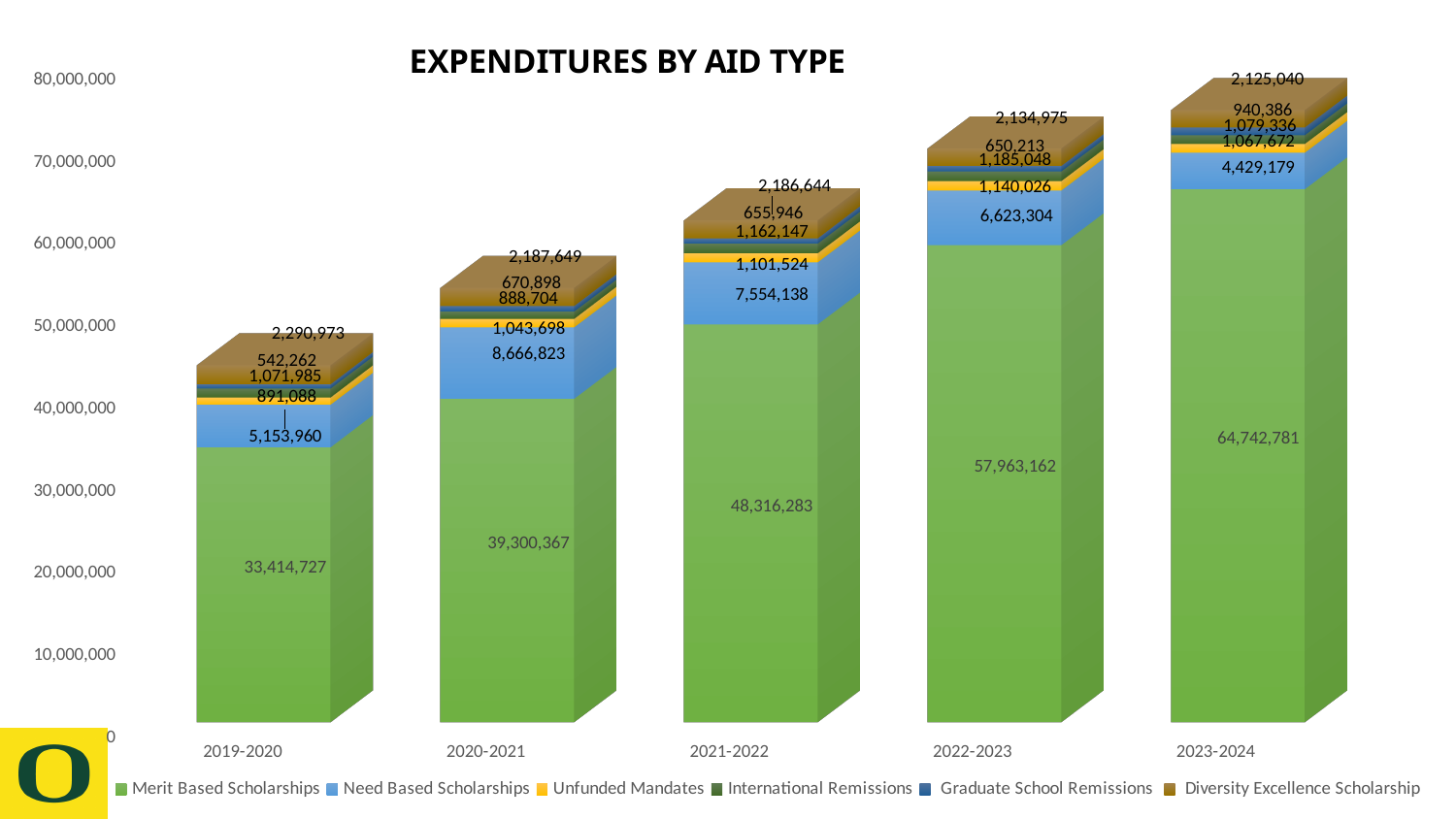
How many series does the legend list? 6 What is the value of Need Based Scholarships for 2020-2021? 8,666,823 Which year has the lowest Need Based Scholarships value? 2023-2024 How many academic years are shown on the x axis? 5 What is the value of Diversity Excellence Scholarship for 2019-2020? 2,290,973 Which year has the highest Merit Based Scholarships value? 2023-2024 What type of chart is shown on the slide? Stacked bar chart What is the value of Merit Based Scholarships for 2021-2022? 48,316,283 Which is larger: Need Based Scholarships in 2021-2022 or in 2022-2023? 2021-2022 What is the difference between Merit Based Scholarships in 2023-2024 and in 2019-2020? 31,328,054 Do Merit Based Scholarships rise or fall from 2019-2020 to 2023-2024? Rise What is the title of the chart? EXPENDITURES BY AID TYPE